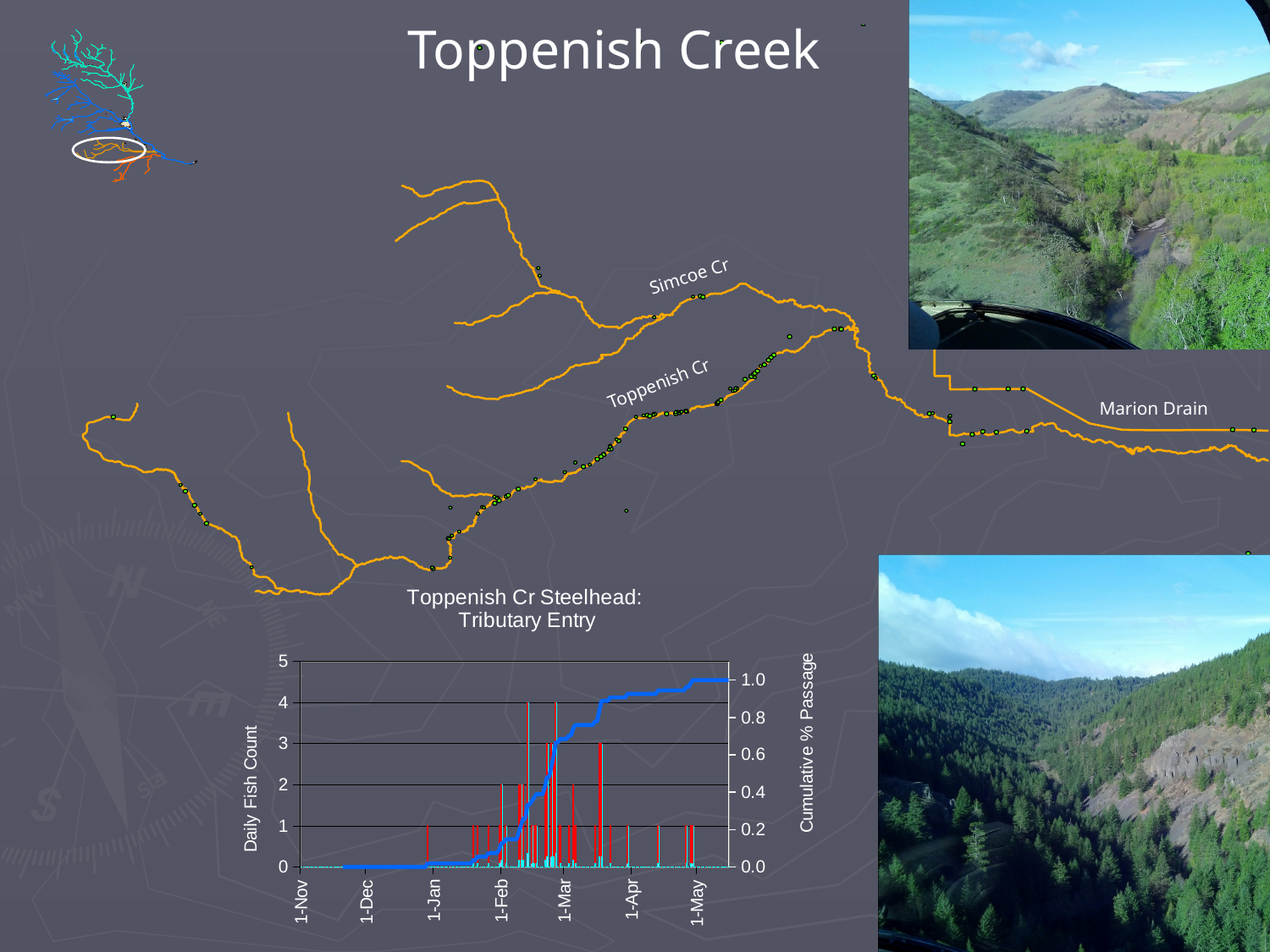
Does the cumulative % passage line in the Toppenish Cr Steelhead chart rise or fall from 1-Nov to 1-May? rise What kind of chart is used to show the daily fish counts in the Toppenish Cr Steelhead chart? bar chart What is the highest value shown on the left vertical axis of the Toppenish Cr Steelhead chart? 5 In the Toppenish Cr Steelhead chart, is the cumulative % passage at 1-May greater or less than 0.8? greater In the Toppenish Cr Steelhead chart, is the cumulative % passage at 1-Jan greater or less than 0.2? less What is the label of the left vertical axis of the Toppenish Cr Steelhead chart? Daily Fish Count In the Toppenish Cr Steelhead chart, is the cumulative % passage at 1-Feb greater or less than 0.4? less What is the label of the right vertical axis of the Toppenish Cr Steelhead chart? Cumulative % Passage How many date labels are shown along the x axis of the Toppenish Cr Steelhead chart? 7